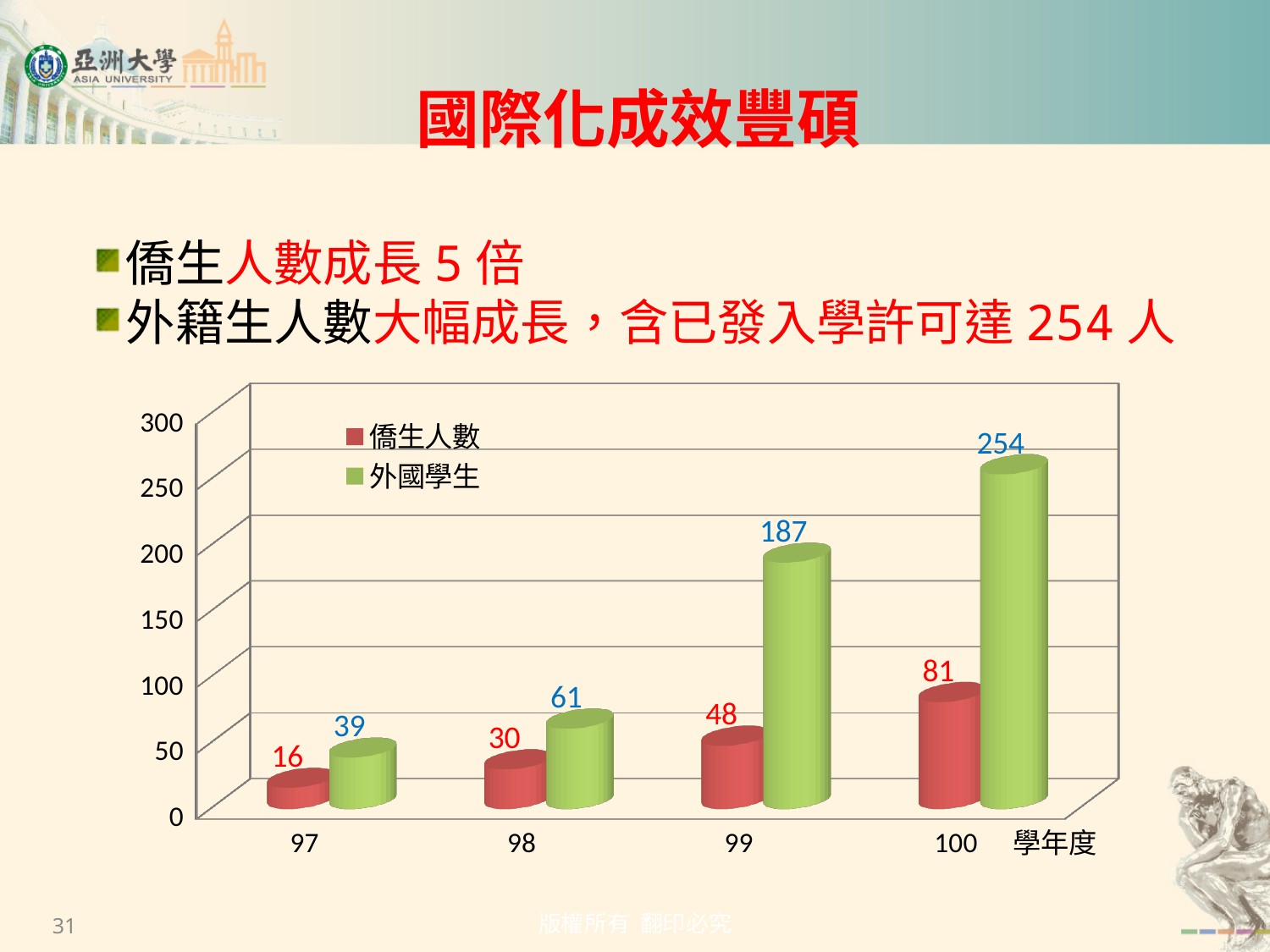
What is the value of 外國學生 for academic year 99? 187 In academic year 98, which is larger: 僑生人數 or 外國學生? 外國學生 What is the difference between the 外國學生 values for academic years 99 and 98? 126 Which academic year has the lowest value for 僑生人數? 97 What is the difference between 外國學生 and 僑生人數 in academic year 100? 173 What is the value of 僑生人數 for academic year 100? 81 How many academic years are shown on the x axis? 4 How many series does the legend list? 2 What kind of chart is shown on the slide? bar chart What is the value of 僑生人數 for academic year 97? 16 Which academic year has the highest value for 外國學生? 100 Do the 外國學生 values rise or fall from academic year 97 to 100? rise